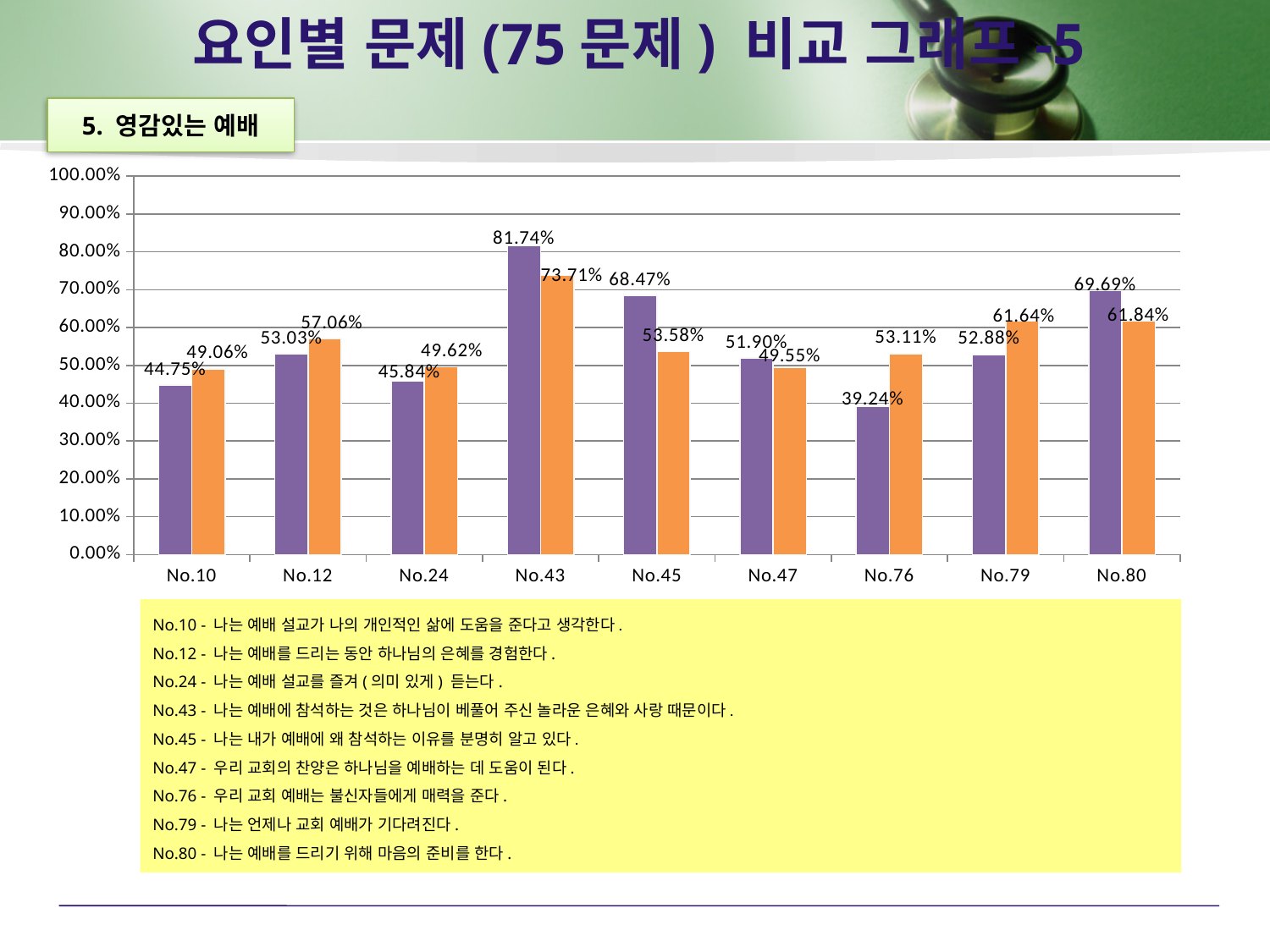
What is the value of the purple bar for No.76? 39.24% Is the purple bar for No.10 greater or less than 50.00%? less Which category has the lowest purple bar? No.76 How many categories are shown on the x axis? 9 What is the value of the purple bar for No.43? 81.74% Which category has the highest orange bar? No.43 For No.80, which bar is larger, the purple or the orange? purple Which category has the highest purple bar? No.43 What is the value of the orange bar for No.79? 61.64% What is the value of the orange bar for No.12? 57.06% What kind of chart is shown on the slide? bar chart What is the difference between the purple and orange bars for No.45? 14.89%